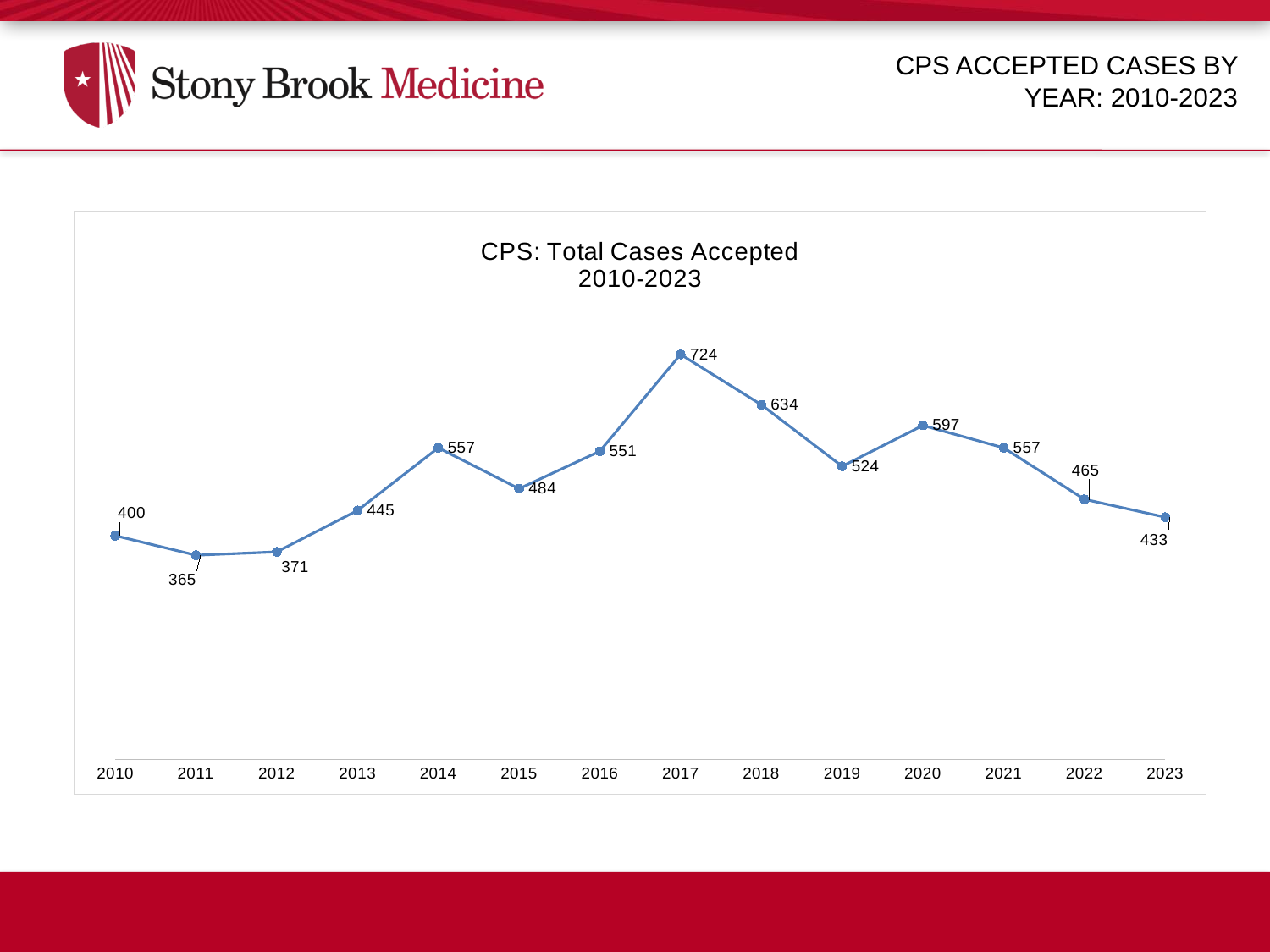
What is the value for 2017? 724 What is the title of the chart? CPS: Total Cases Accepted 2010-2023 What is the value for 2011? 365 What is the value for 2023? 433 Which year has the highest number of cases accepted? 2017 What kind of chart is shown? Line chart Do the values rise or fall from 2017 to 2019? Fall How many years are plotted on the chart? 14 Which is larger, the value for 2020 or the value for 2019? 2020 What is the difference between the values for 2010 and 2023? 33 Which year has the lowest number of cases accepted? 2011 What is the difference between the values for 2017 and 2018? 90